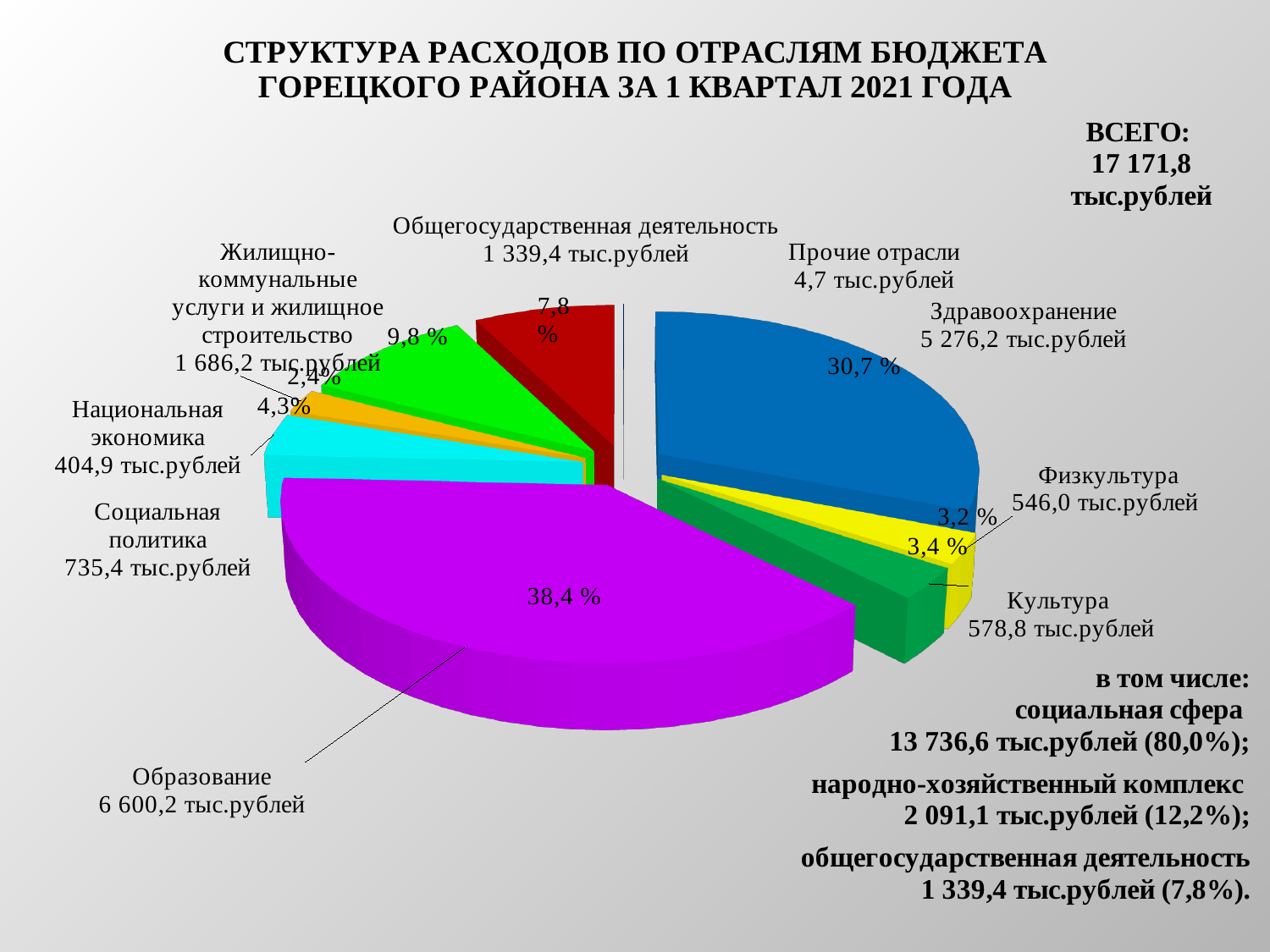
What is the total (ВСЕГО) of all expenditures shown on the slide? 17 171,8 тыс.рублей What is the value for Образование? 6 600,2 тыс.рублей Which is larger, the value for Культура or the value for Физкультура? Культура What share of the pie does Жилищно-коммунальные услуги и жилищное строительство represent? 9,8 % Which category has the largest share of the pie? Образование What is the value for Физкультура? 546,0 тыс.рублей What is the value for Здравоохранение? 5 276,2 тыс.рублей What share of the pie does Здравоохранение represent? 30,7 % Which category has the smallest value? Прочие отрасли What is the difference between the values for Образование and Здравоохранение? 1 324,0 тыс.рублей How many categories (slices) does the pie chart show? 9 What kind of chart is shown on the slide? pie chart